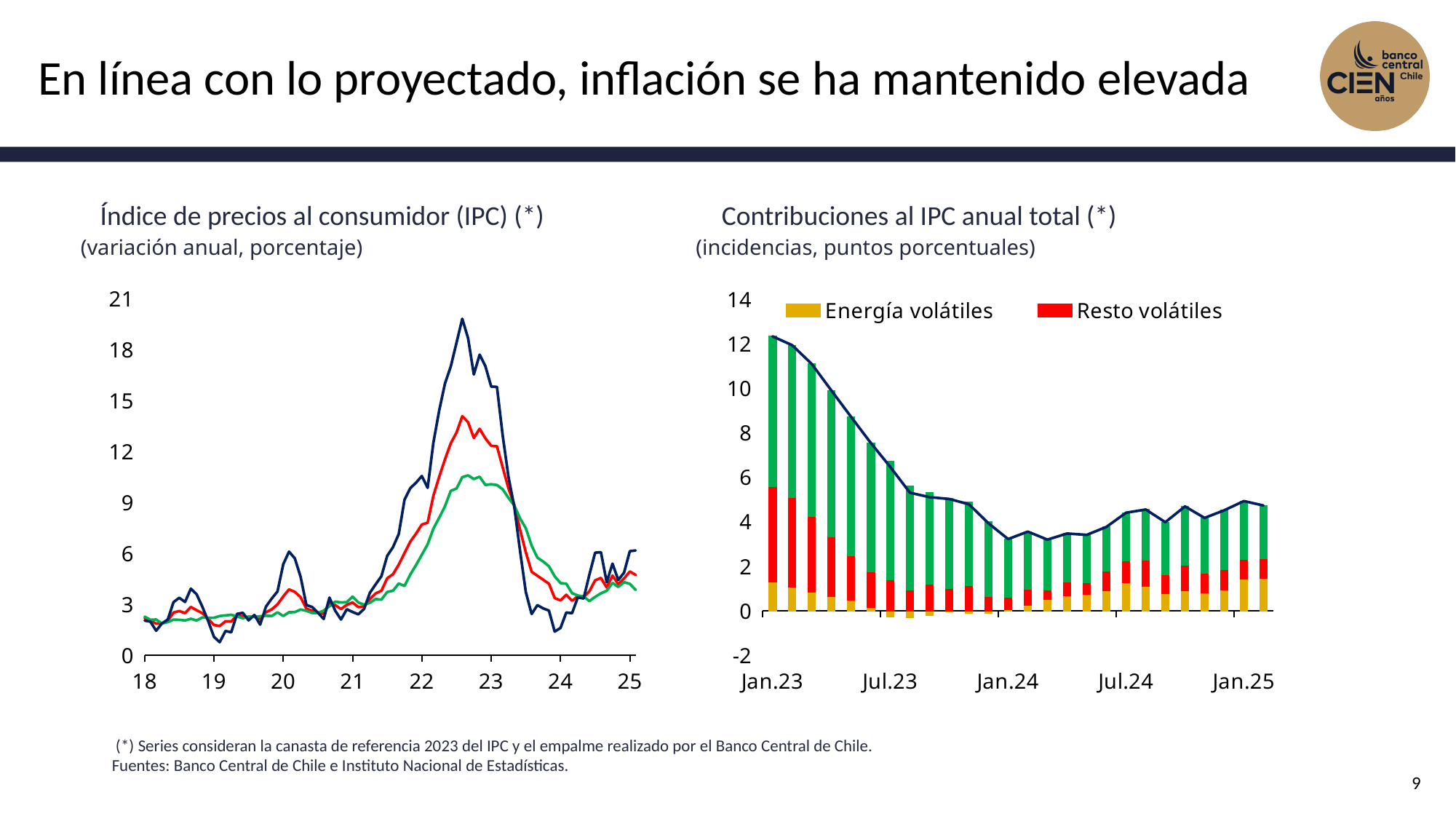
On the right chart, 'Contribuciones al IPC anual total', do the totals rise or fall from Jan.23 to Jan.24? fall On the left chart, 'Índice de precios al consumidor (IPC)', which line reaches the highest peak: the dark blue, red or green line? dark blue What kind of chart is the left chart, 'Índice de precios al consumidor (IPC)'? line chart How many lines are plotted on the left chart, 'Índice de precios al consumidor (IPC)'? 3 On the left chart, 'Índice de precios al consumidor (IPC)', is the peak of the green line greater or less than 12? less On the left chart, 'Índice de precios al consumidor (IPC)', is the peak of the dark blue line greater or less than 18? greater On the right chart, 'Contribuciones al IPC anual total', which month has the tallest stacked bar? Jan.23 On the right chart, 'Contribuciones al IPC anual total', is the total for Jan.23 greater or less than 10? greater On the left chart, 'Índice de precios al consumidor (IPC)', do the values rise or fall between 23 and 24 on the x axis? fall On the right chart, 'Contribuciones al IPC anual total', which colour represents 'Energía volátiles'? yellow What kind of chart is the right chart, 'Contribuciones al IPC anual total'? stacked bar chart with a line How many series does the legend of the right chart, 'Contribuciones al IPC anual total', list? 2